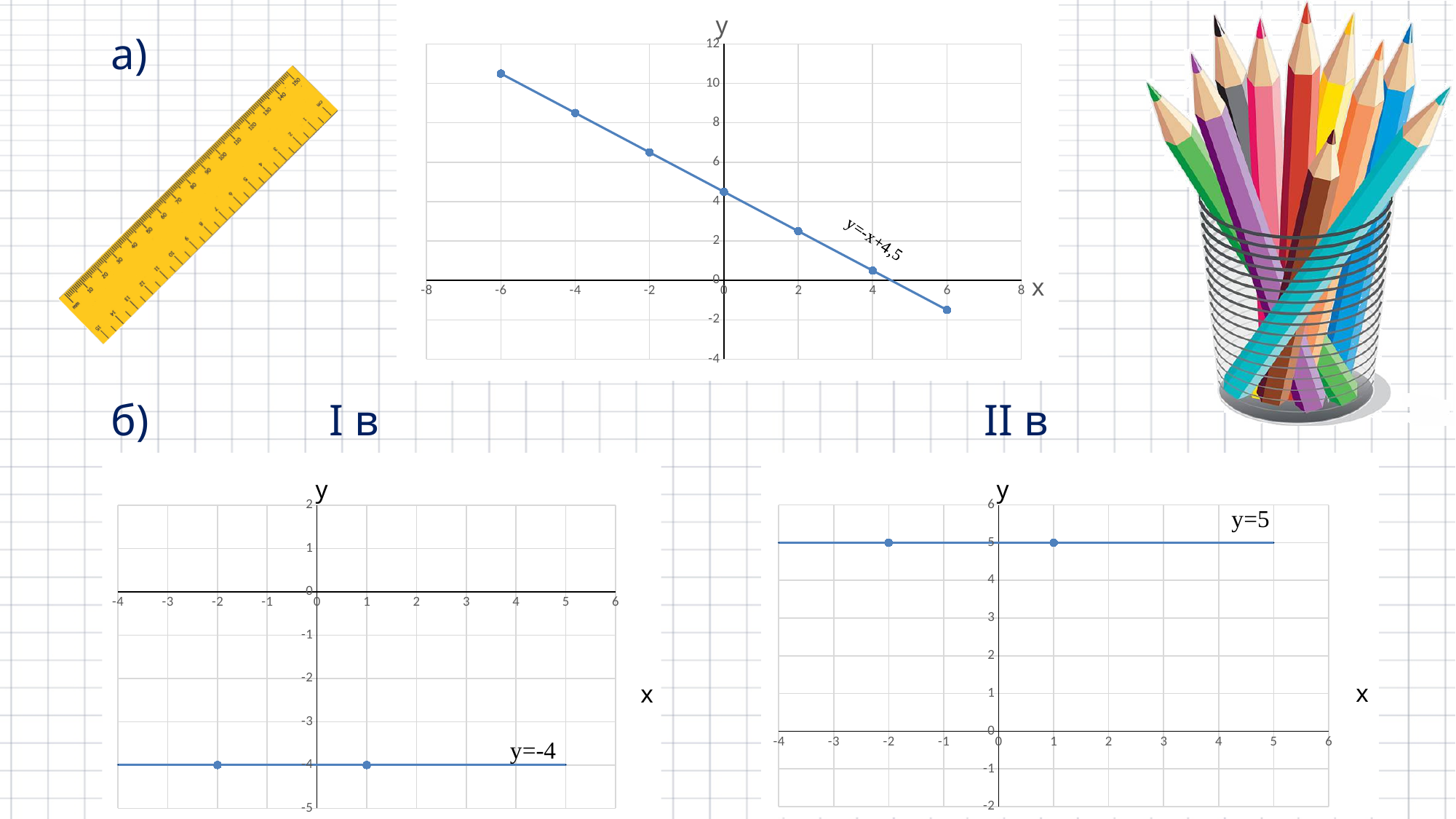
What kind of chart is the chart labelled a) at the top of the slide? line chart What is the difference between the y value of the line in the chart labelled II в and the y value of the line in the chart labelled I в? 9 Which chart shows a line with the larger y value: the chart labelled I в or the chart labelled II в? II в On the chart labelled a) at the top of the slide, at which x value is the plotted y value highest? -6 On the chart labelled II в at the bottom right, what is the y value of the plotted line? 5 On the chart labelled a) at the top of the slide, is the y value at x = -6 greater or less than 10? greater How many data points are marked on the line in the chart labelled I в at the bottom left? 2 On the chart labelled a) at the top of the slide, do the y values rise or fall as x increases? fall On the chart labelled I в at the bottom left, what is the y value of the plotted line? -4 On the chart labelled a) at the top of the slide, is the y value at x = 6 greater or less than 0? less What equation is written as a label on the line in the chart labelled a) at the top of the slide? y=-x+4,5 How many data points are plotted on the chart labelled a) at the top of the slide? 7